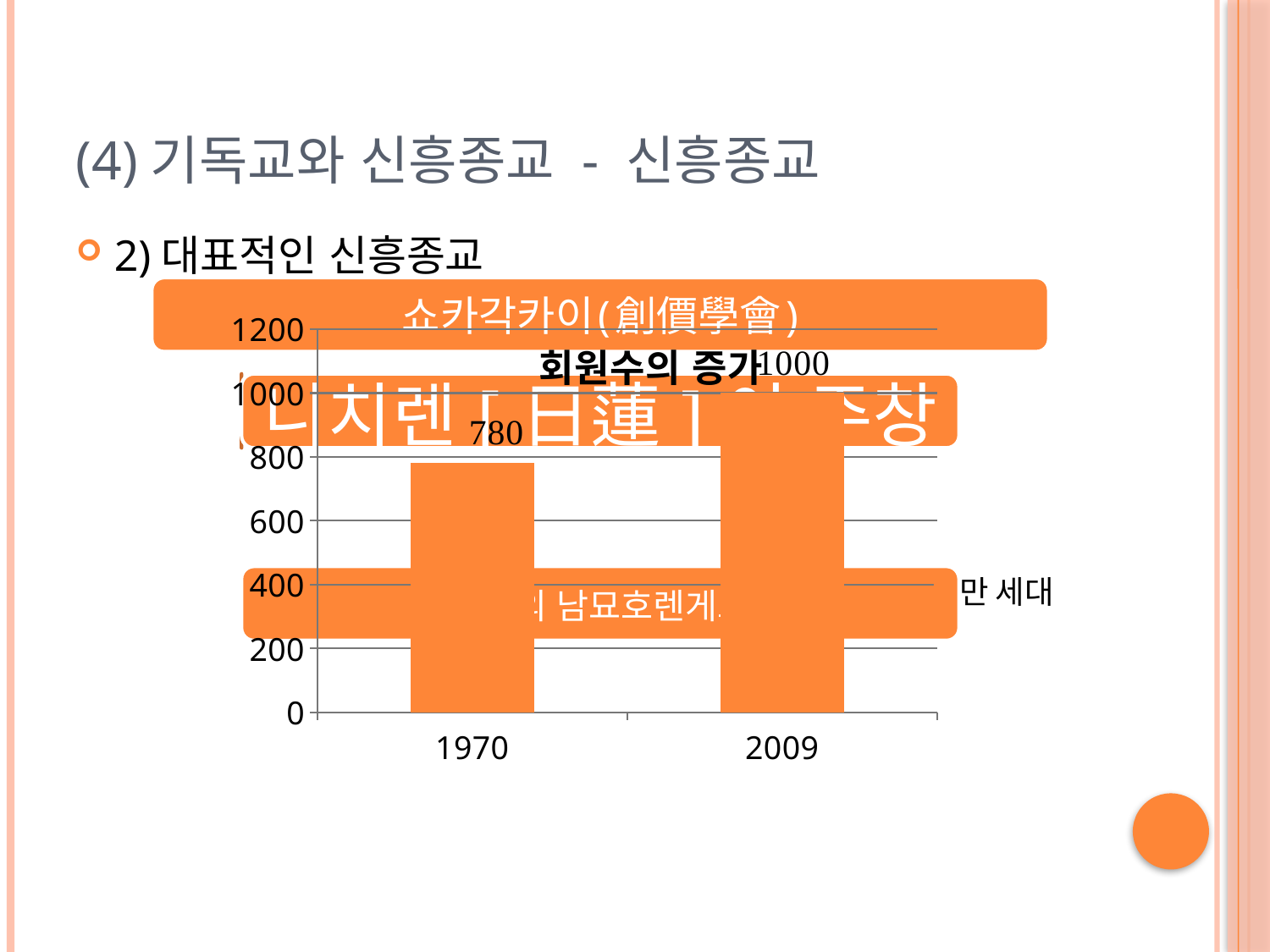
What is the value for 1970 in the chart? 780 What is the value for 2009 in the chart? 1000 Is the value for 2009 greater or less than 800? greater Which year has the lower value in the chart? 1970 What is the title of the chart? 회원수의 증가 Do the values rise or fall from 1970 to 2009? rise How many categories are shown on the x axis of the chart? 2 What kind of chart is shown on the slide? bar chart Is the value for 2009 larger or smaller than the value for 1970? larger Which year has the higher value in the chart? 2009 What is the difference between the values for 2009 and 1970? 220 Is the value for 1970 greater or less than 800? less